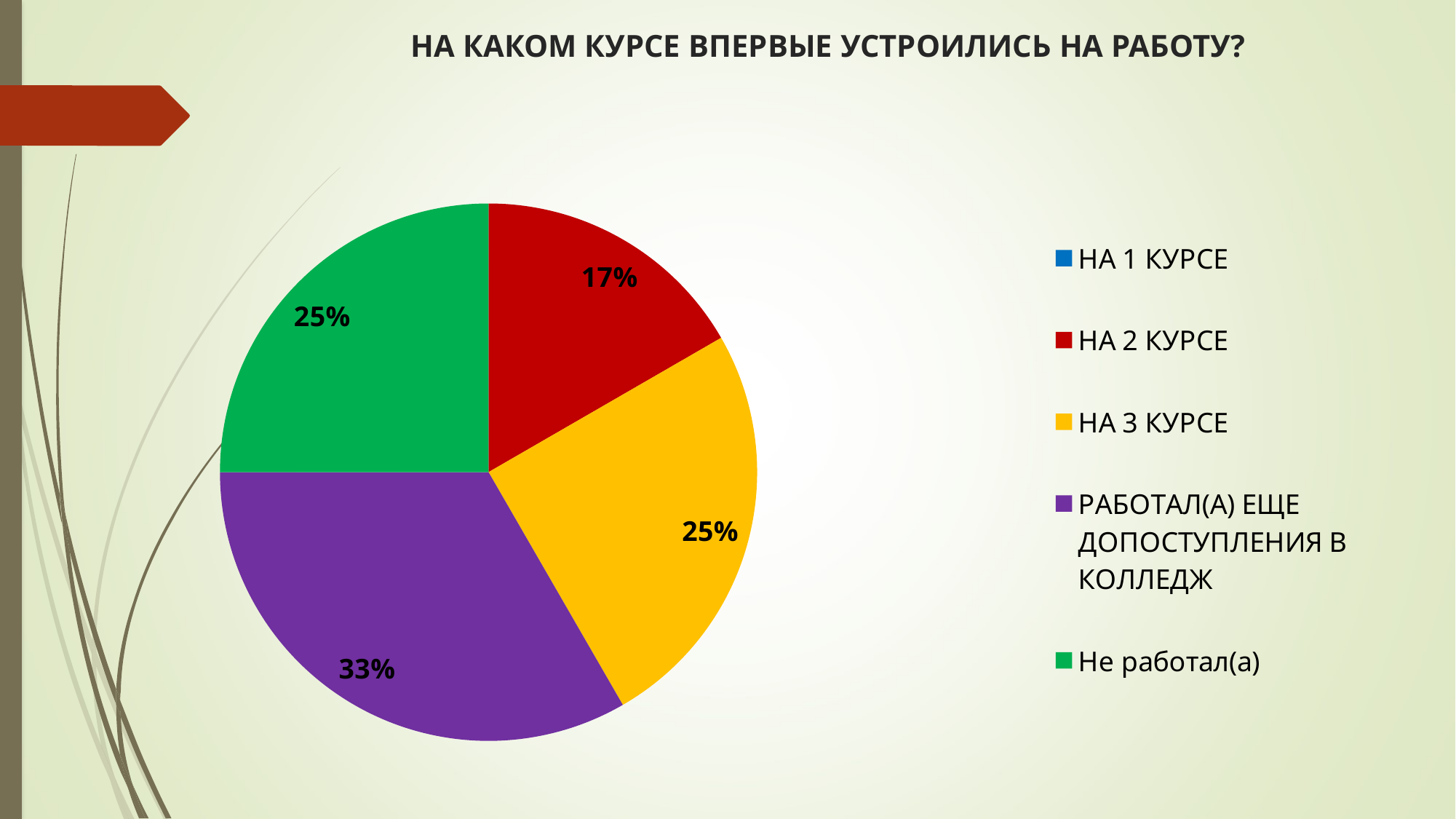
Which of the labelled slices is the smallest? НА 2 КУРСЕ What kind of chart is shown on the slide? Pie chart How many entries does the legend list? 5 What percentage is shown for the slice "Не работал(а)"? 25% What percentage is shown for the slice "РАБОТАЛ(А) ЕЩЕ ДОПОСТУПЛЕНИЯ В КОЛЛЕДЖ"? 33% What is the difference in percentage points between the "РАБОТАЛ(А) ЕЩЕ ДОПОСТУПЛЕНИЯ В КОЛЛЕДЖ" slice and the "НА 2 КУРСЕ" slice? 16 percentage points What is the title of the chart? НА КАКОМ КУРСЕ ВПЕРВЫЕ УСТРОИЛИСЬ НА РАБОТУ? What percentage is shown for the slice "НА 2 КУРСЕ"? 17% What percentage is shown for the slice "НА 3 КУРСЕ"? 25% What colour is the slice for "Не работал(а)"? Green Which category has the largest slice of the pie? РАБОТАЛ(А) ЕЩЕ ДОПОСТУПЛЕНИЯ В КОЛЛЕДЖ Which slice is larger: "НА 3 КУРСЕ" or "НА 2 КУРСЕ"? НА 3 КУРСЕ